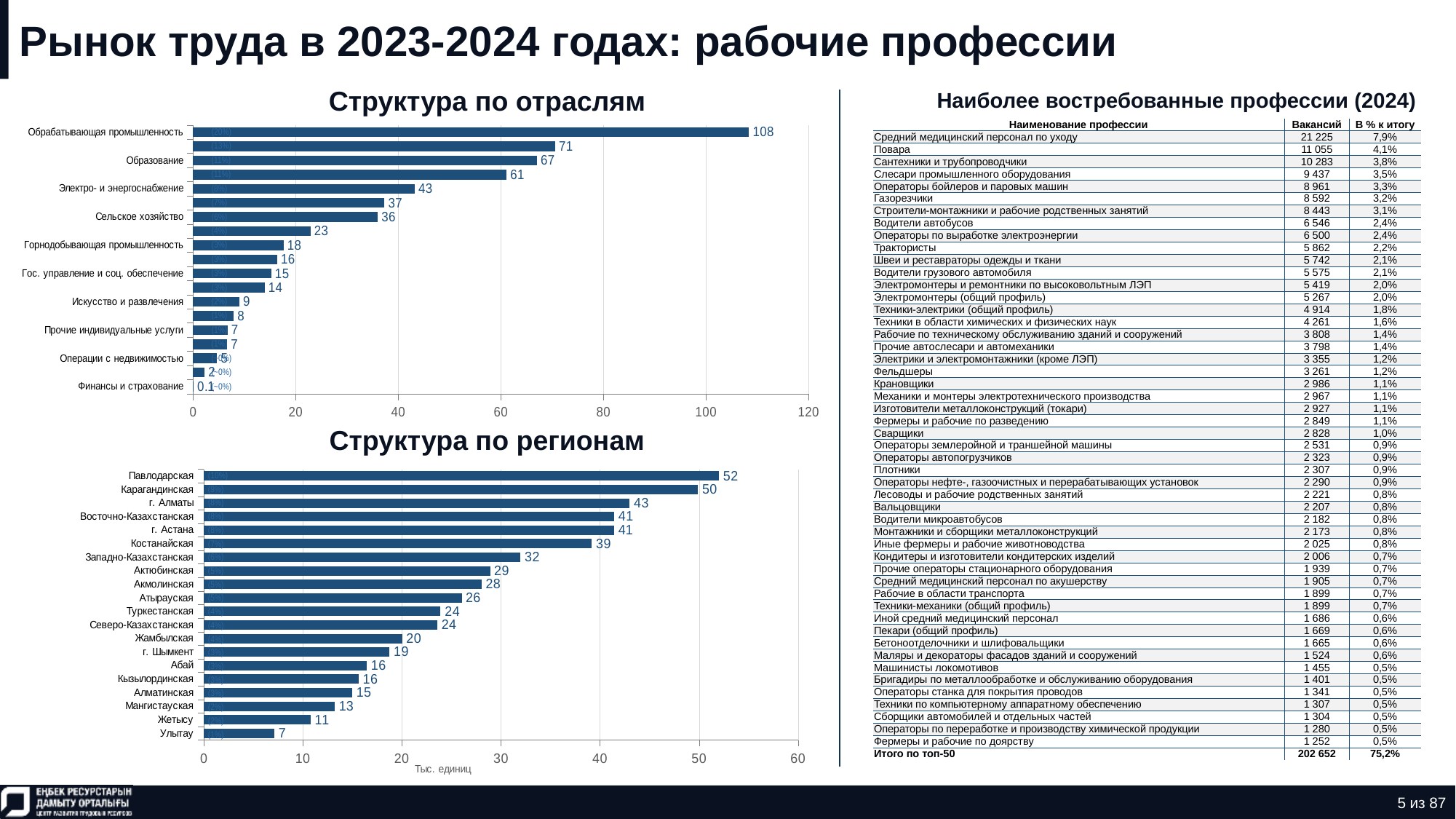
In the chart 'Структура по отраслям', what is the difference between Образование and Электро- и энергоснабжение? 24 In the chart 'Структура по регионам', what is the value for Карагандинская? 50 In the chart 'Структура по отраслям', which is larger: Горнодобывающая промышленность or Гос. управление и соц. обеспечение? Горнодобывающая промышленность In the chart 'Структура по отраслям', what is the value for Обрабатывающая промышленность? 108 In the chart 'Структура по регионам', is the value for Западно-Казахстанская greater or less than 30? greater In the chart 'Структура по регионам', what is the difference between Павлодарская and Костанайская? 13 In the chart 'Структура по регионам', which region has the lowest value? Улытау What type of chart is 'Структура по регионам'? Bar chart In the chart 'Структура по отраслям', which category has the highest value? Обрабатывающая промышленность In the chart 'Структура по регионам', how many regions are shown? 20 What unit is shown on the x axis of the chart 'Структура по регионам'? Тыс. единиц In the chart 'Структура по отраслям', what is the value for Сельское хозяйство? 36